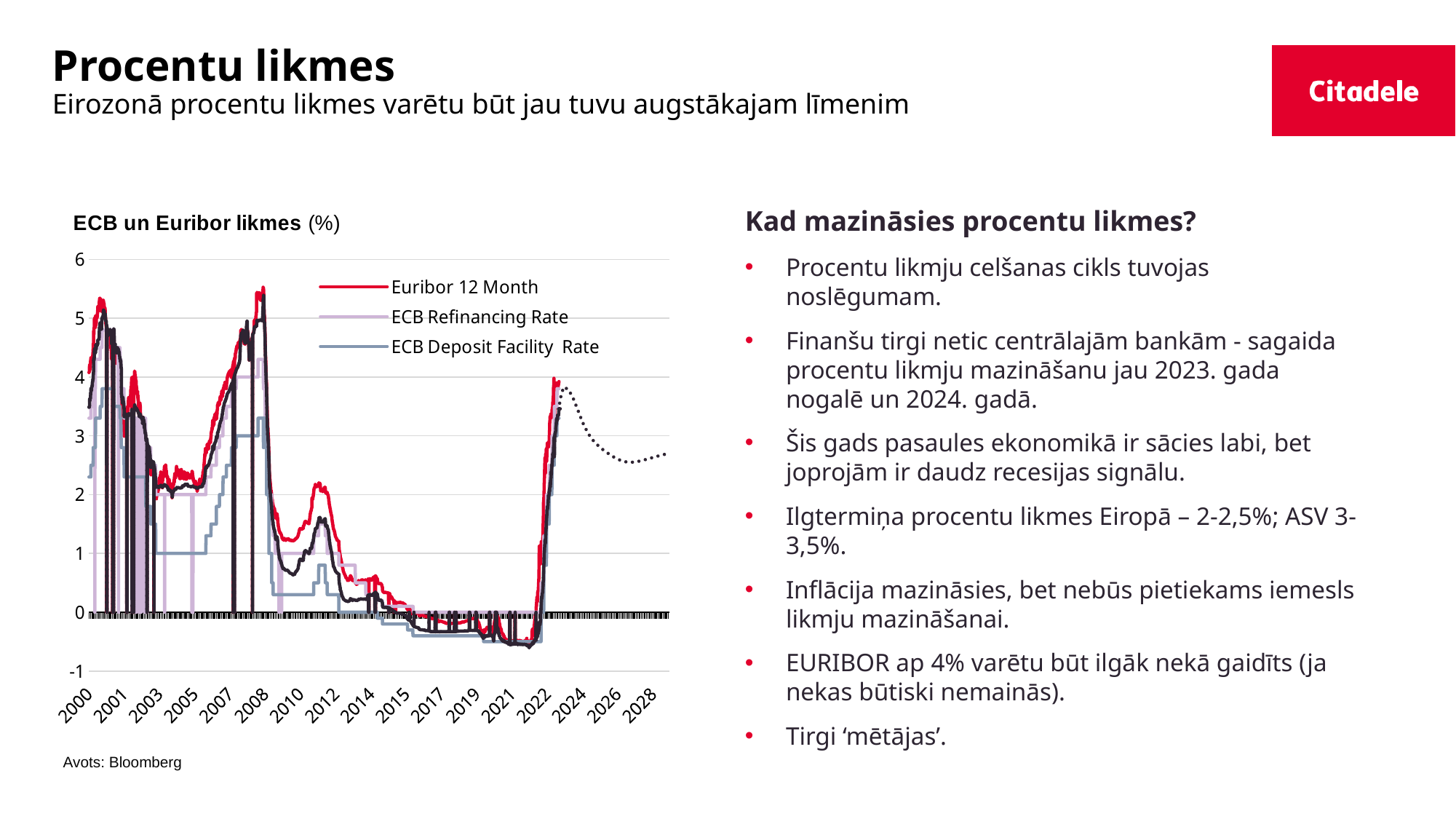
What kind of chart is shown on the slide? line chart What is the title of the chart? ECB un Euribor likmes (%) Is the peak value of Euribor 12 Month around 2008 greater or less than 5? greater Around 2008, is the value of Euribor 12 Month larger or smaller than the value of ECB Deposit Facility Rate? larger Which series in the chart is drawn in red? Euribor 12 Month What is the highest tick value shown on the y axis of the chart? 6 How many series does the legend of the chart list? 3 Which series reaches the highest value around 2008? Euribor 12 Month Is the value of ECB Deposit Facility Rate around 2019 greater or less than 0? less Does Euribor 12 Month rise or fall between 2021 and 2022? rise Does Euribor 12 Month rise or fall between 2008 and 2015? fall